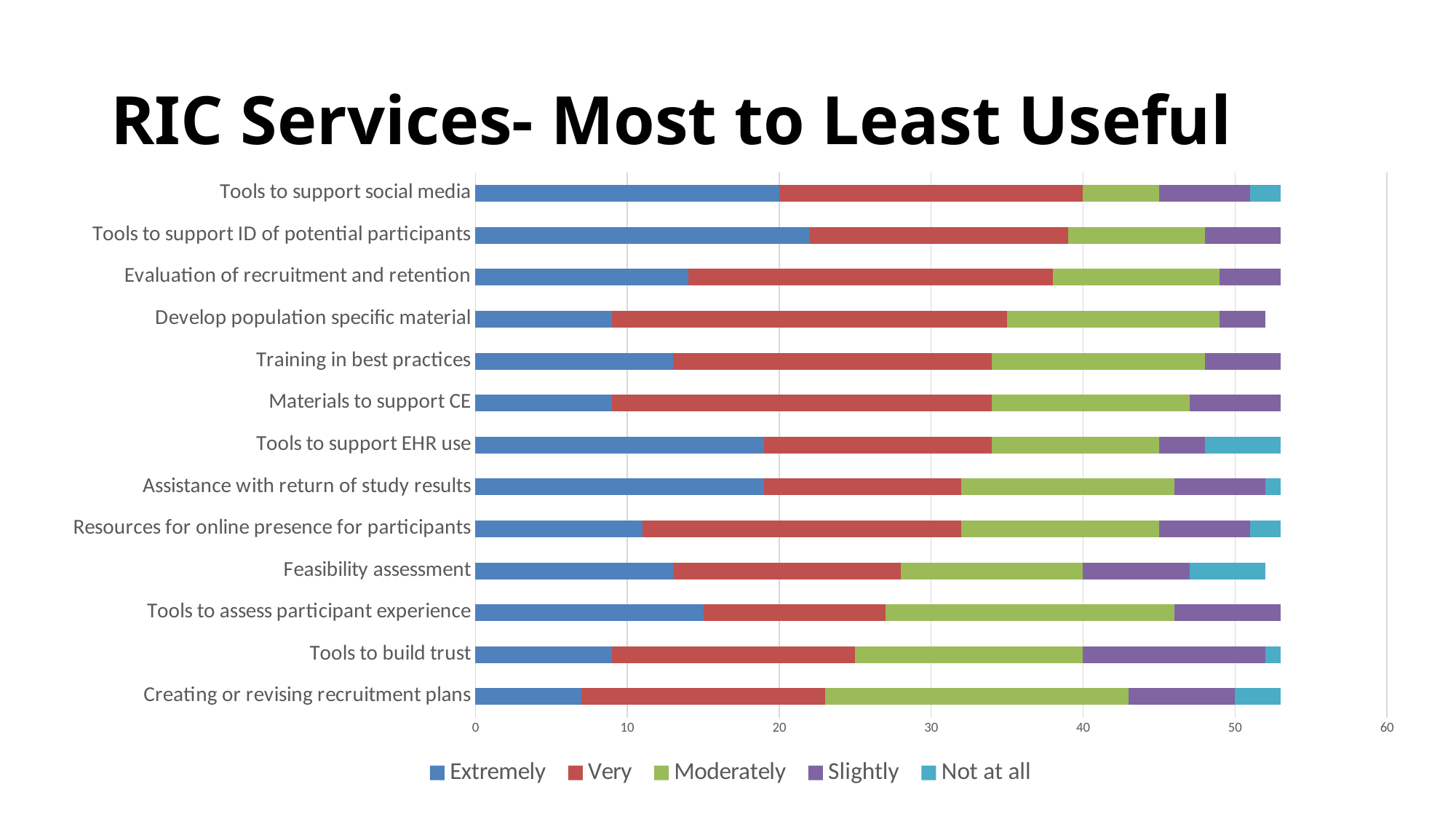
Is the "Extremely" value for Creating or revising recruitment plans greater or less than 10? less Which colour represents the "Very" series in the legend? red Which category has the largest "Extremely" segment? Tools to support ID of potential participants Is the "Extremely" value for Tools to support ID of potential participants greater or less than 20? greater Is the "Extremely" value for Tools to support EHR use greater or less than 10? greater Which category has the smallest "Extremely" segment? Creating or revising recruitment plans What is the title of the chart? RIC Services- Most to Least Useful How many service categories are listed on the chart? 13 What kind of chart is shown on the slide? stacked bar chart Which has the larger "Extremely" value: Tools to support social media or Creating or revising recruitment plans? Tools to support social media How many series does the legend list? 5